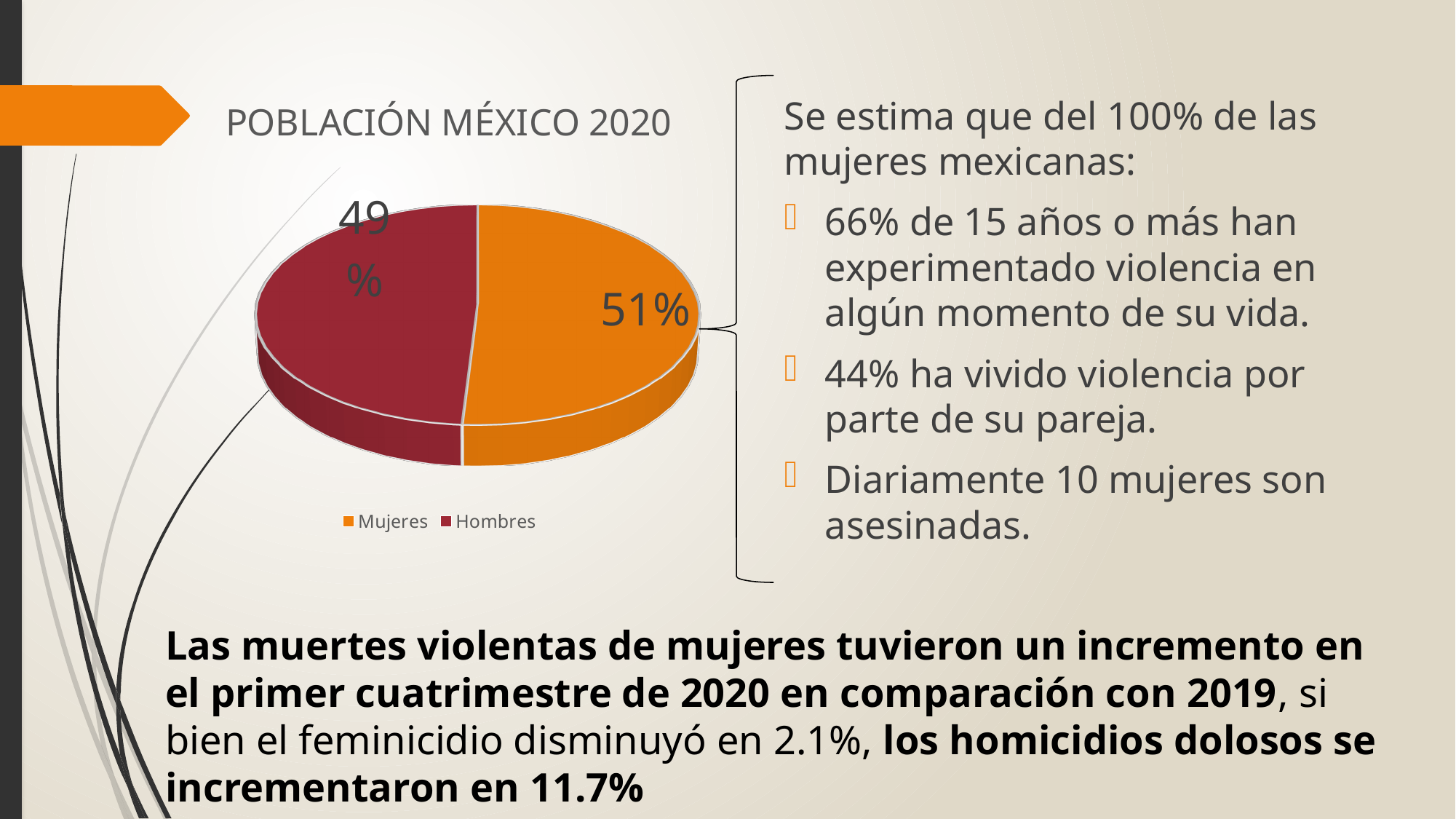
What share of the pie is labelled for Mujeres? 51% What is the title of the chart? POBLACIÓN MÉXICO 2020 What kind of chart is shown on the slide? pie chart Which colour represents Hombres in the pie chart? dark red What is the difference in percentage points between the Mujeres and Hombres slices? 2% What share of the pie is labelled for Hombres? 49% Which category has the smallest slice in the pie chart? Hombres How many entries does the legend list? 2 Which category has the larger slice, Mujeres or Hombres? Mujeres How many slices does the pie chart have? 2